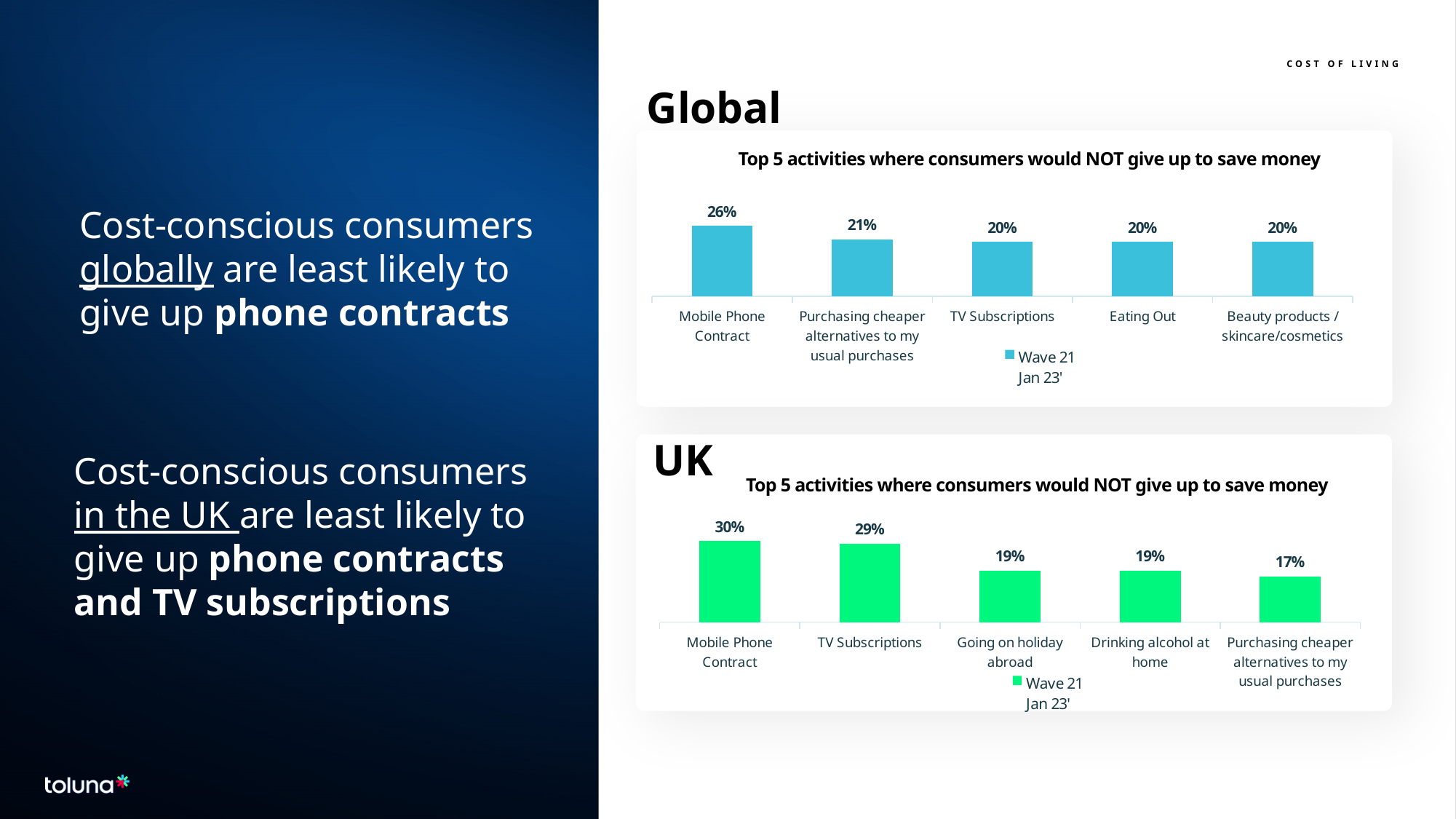
In the UK chart, what is the difference between Mobile Phone Contract and Going on holiday abroad? 11% In the Global chart, what is the value for Purchasing cheaper alternatives to my usual purchases? 21% In the Global chart, how many categories are shown? 5 In the Global chart, which category has the highest value? Mobile Phone Contract In the UK chart, what is the value for Purchasing cheaper alternatives to my usual purchases? 17% In the UK chart, what is the value for TV Subscriptions? 29% In the UK chart, which category has the lowest value? Purchasing cheaper alternatives to my usual purchases What type of chart is the UK chart? Bar chart In the Global chart, what is the difference between Mobile Phone Contract and TV Subscriptions? 6% What series does the legend of the Global chart list? Wave 21 Jan 23' In the Global chart, what is the value for Mobile Phone Contract? 26% In the UK chart, which is larger: Drinking alcohol at home or Purchasing cheaper alternatives to my usual purchases? Drinking alcohol at home